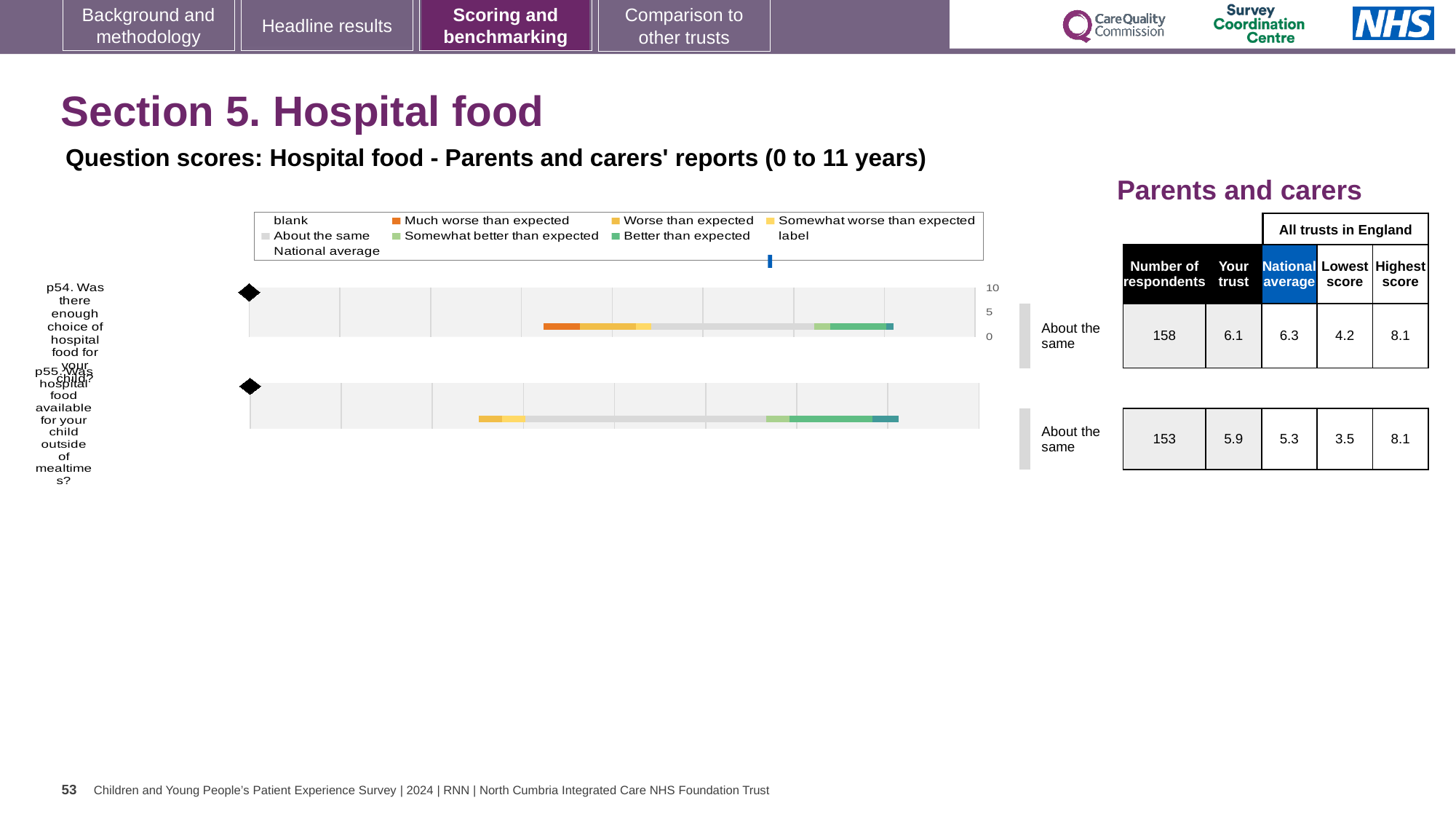
Which question has the lower 'Lowest score' across all trusts in England, p54 or p55? p55 What is the national average score for p55 (hospital food available outside of mealtimes)? 5.3 What is the benchmark category shown for p54 (enough choice of hospital food)? About the same How many survey questions are plotted on the chart? 2 For p55, is the 'Your trust' score higher or lower than the national average? higher What is the benchmark category shown for p55 (hospital food available outside of mealtimes)? About the same What is the highest score across all trusts in England for p55? 8.1 What is the 'Your trust' score for p54 (enough choice of hospital food)? 6.1 What kind of chart is used to show the question scores for hospital food? bar chart What colour does the legend use for 'Much worse than expected'? orange How many respondents answered p54 (enough choice of hospital food)? 158 What is the difference between the national average and the 'Your trust' score for p54? 0.2